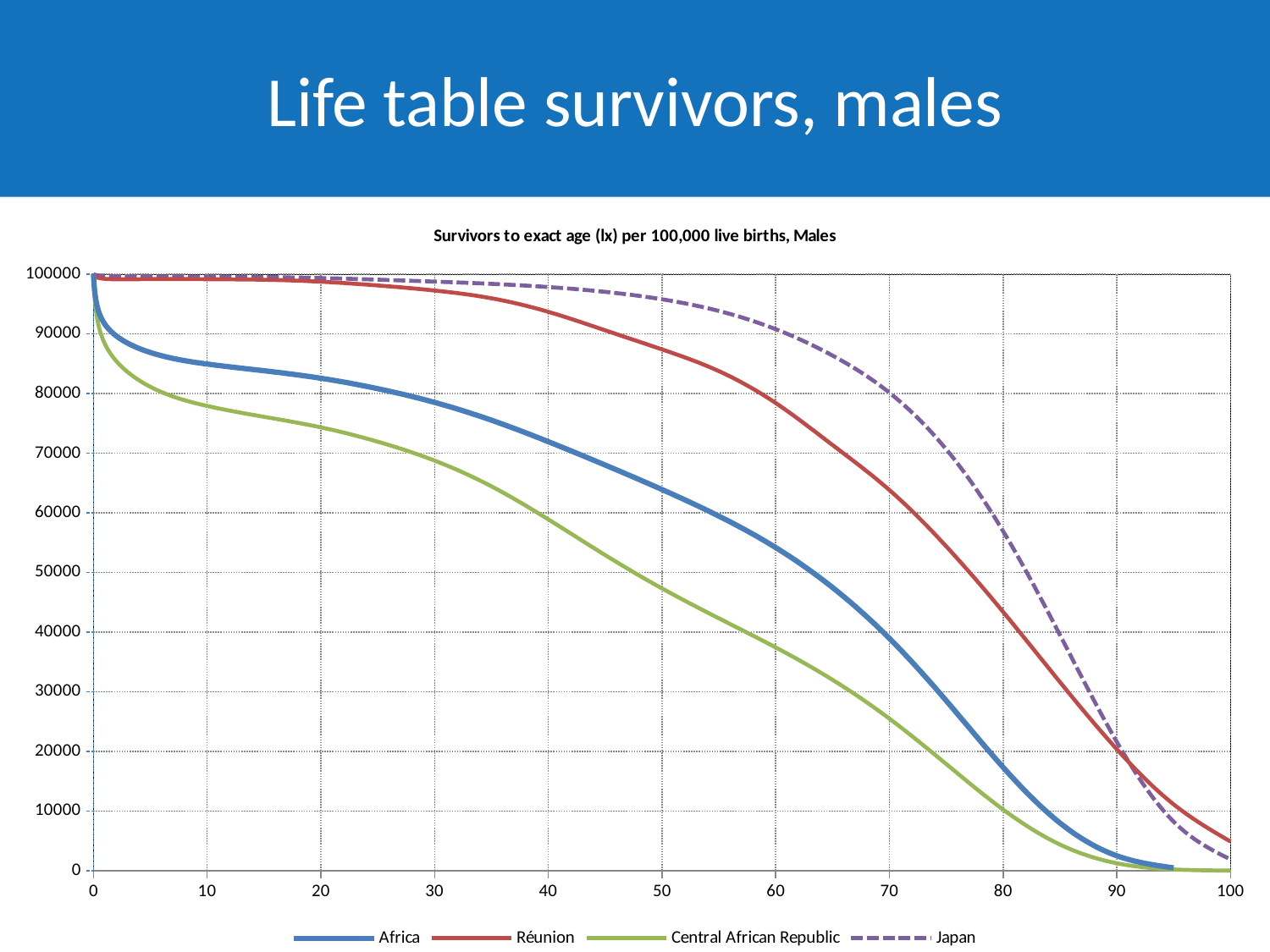
How many series does the legend list? 4 Is the value for Central African Republic at age 40 greater or less than 70000? less At age 50, which series has more survivors, Réunion or Africa? Réunion What kind of chart is shown on the slide? Line chart Is the value for Japan at age 60 greater or less than 80000? greater Which series is drawn with a dashed line? Japan Is the value for Africa at age 80 greater or less than 30000? less Which series has the highest number of survivors at age 50? Japan Do the survivor values rise or fall as age increases along the x axis? Fall Which series has the lowest number of survivors at age 50? Central African Republic What is the title of the chart? Survivors to exact age (lx) per 100,000 live births, Males